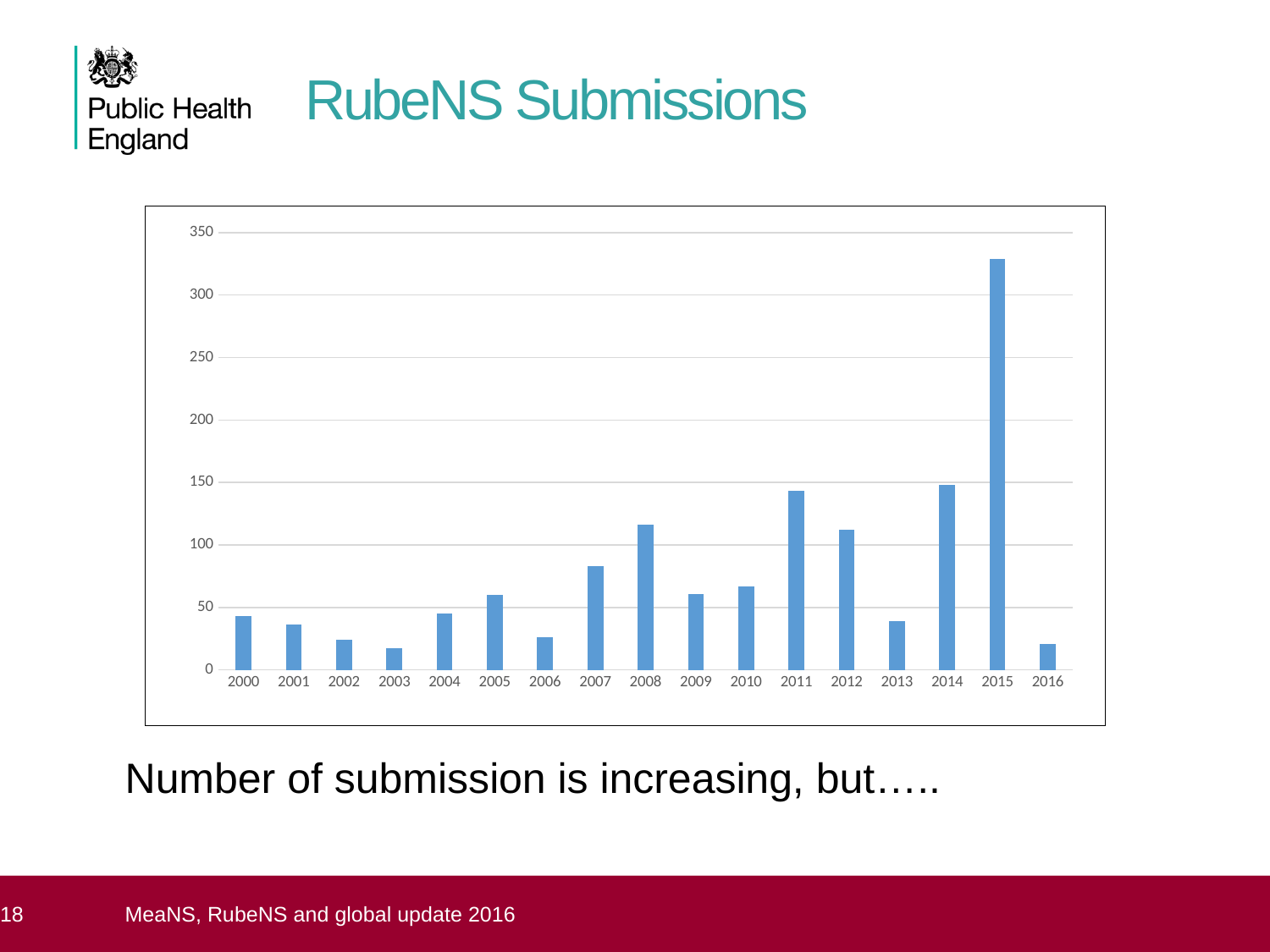
What is the title of the slide containing the chart? RubeNS Submissions Is the value for 2015 greater or less than 300? greater Is the value for 2016 greater or less than 50? less Which year has the larger value, 2011 or 2008? 2011 Is the value for 2003 greater or less than 50? less Which year has the larger value, 2005 or 2006? 2005 Overall, do the values rise or fall from 2000 to 2015? rise How many years are shown on the x axis of the chart? 17 What kind of chart is shown on the slide? bar chart Which year has the highest number of RubeNS submissions? 2015